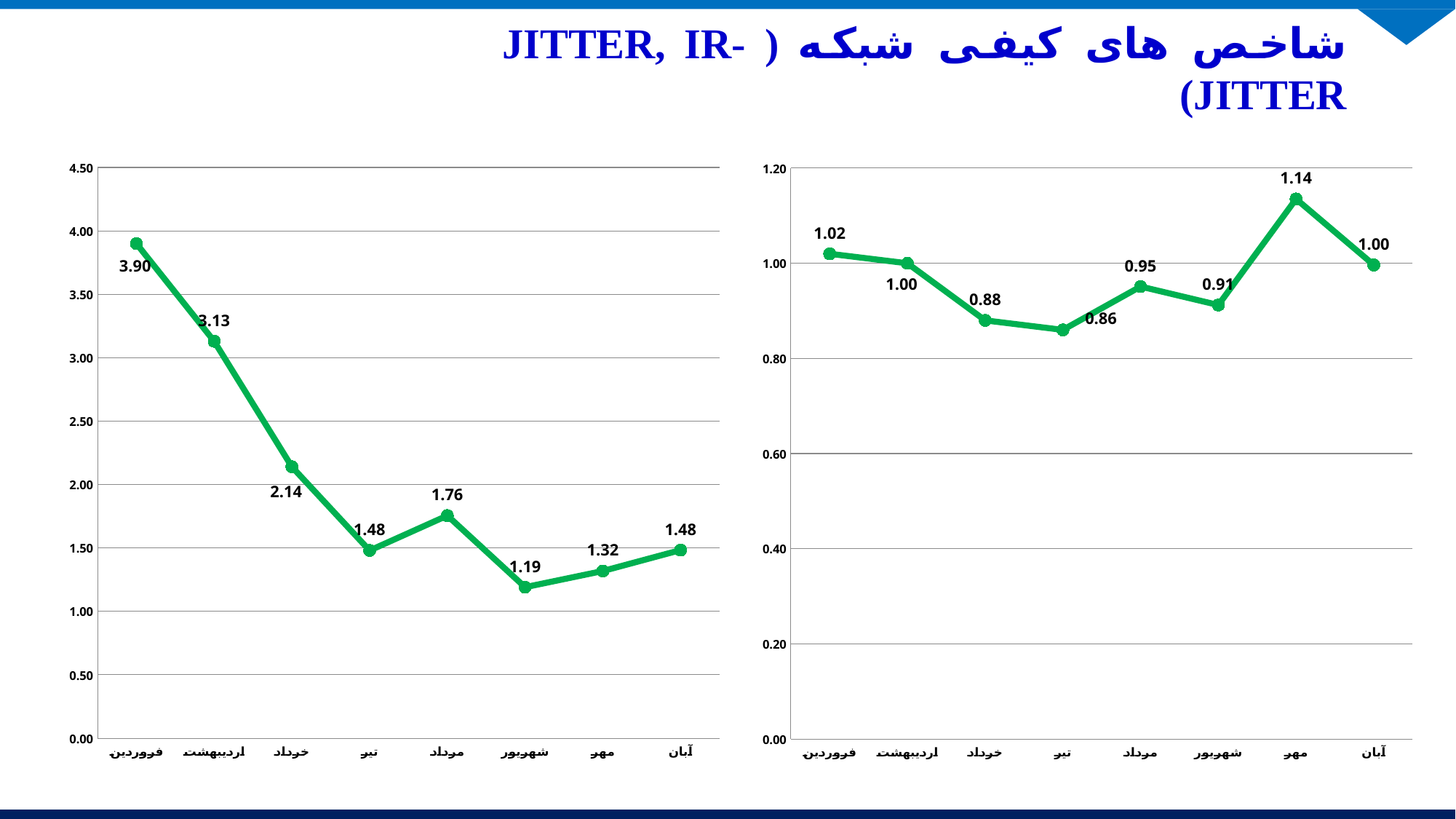
In the right chart, what is the value for تیر? 0.86 In the left chart, which month has the lowest value? شهریور In the left chart, which month has the highest value? فروردین In the right chart, which is larger, the value for مرداد or the value for شهریور? مرداد In the left chart, what is the value for فروردین? 3.90 In the left chart, what is the difference between the values for فروردین and اردیبهشت? 0.77 In the right chart, what is the difference between the values for مهر and آبان? 0.14 In the left chart, what is the value for شهریور? 1.19 How many data points are plotted in the left chart? 8 In the right chart, what is the value for مهر? 1.14 In the right chart, which month has the lowest value? تیر What kind of chart is the right chart? line chart